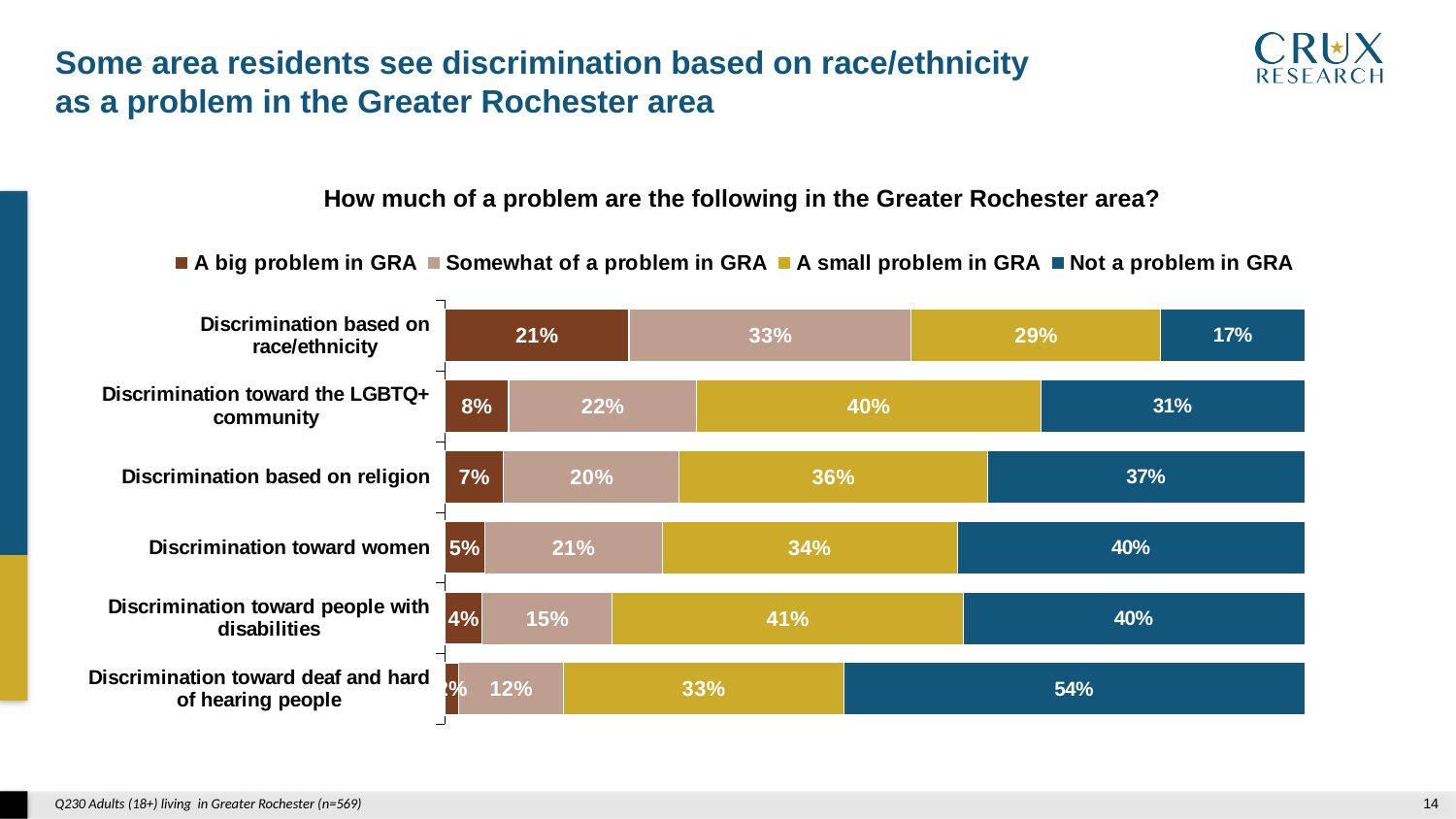
Which category has the lowest share of respondents saying it is not a problem in GRA? Discrimination based on race/ethnicity What percentage say discrimination toward the LGBTQ+ community is a small problem in GRA? 40% How many series does the legend list? 4 What is the combined percentage of respondents who say discrimination toward women is either a big problem or somewhat of a problem in GRA? 26% How many discrimination categories are shown in the chart? 6 What percentage of respondents say discrimination based on race/ethnicity is a big problem in GRA? 21% What type of chart is shown on the slide? Stacked bar chart Which category has the highest share of respondents saying it is a big problem in GRA? Discrimination based on race/ethnicity What percentage say discrimination toward deaf and hard of hearing people is not a problem in GRA? 54% What question is the chart based on, as shown in the chart title? How much of a problem are the following in the Greater Rochester area? Which is larger: the 'Somewhat of a problem in GRA' share for discrimination based on race/ethnicity or for discrimination toward people with disabilities? Discrimination based on race/ethnicity What is the difference between the 'Not a problem in GRA' percentages for discrimination toward deaf and hard of hearing people and discrimination based on religion? 17 percentage points